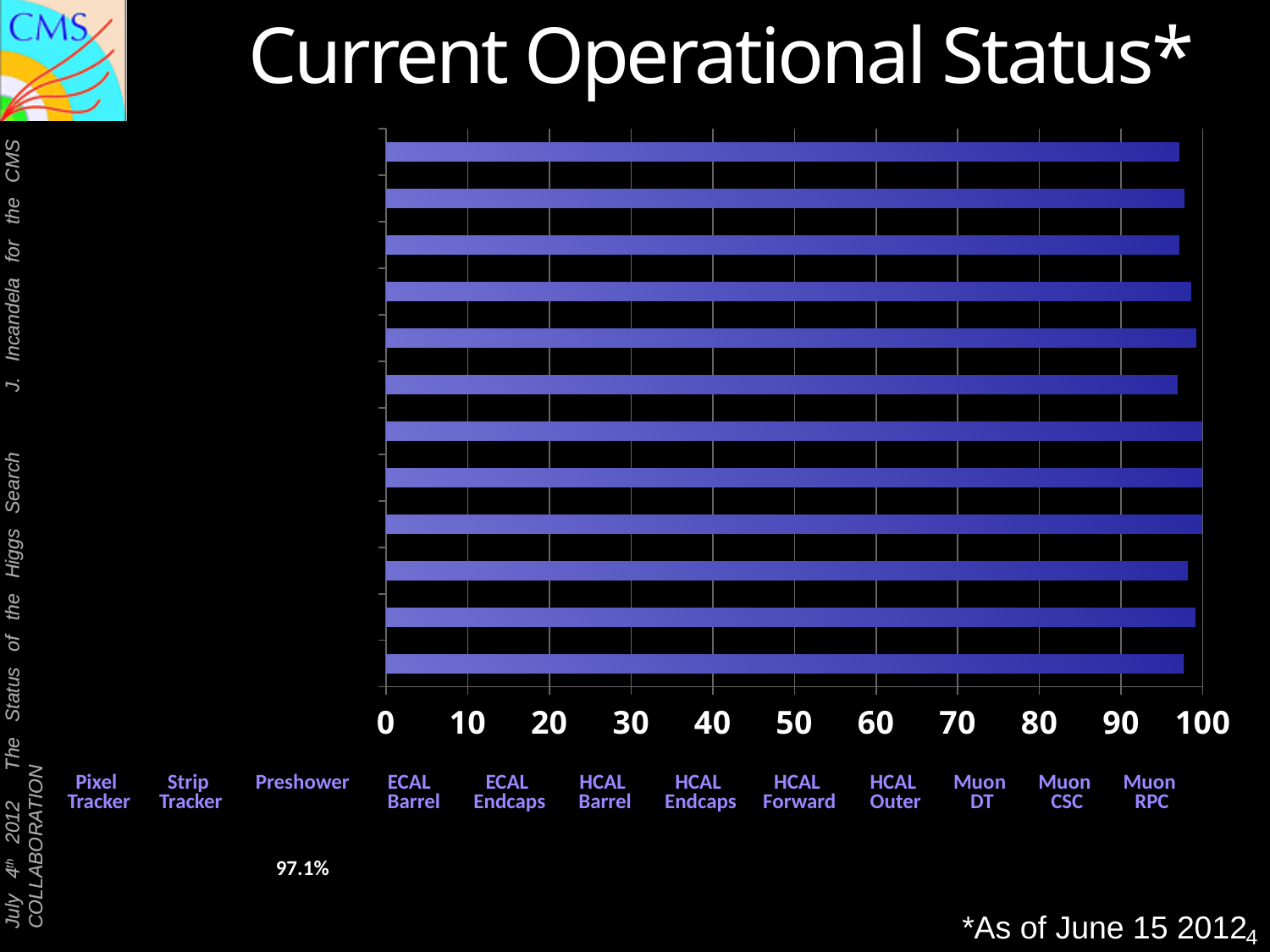
What is the highest value shown on the x axis of the chart? 100 How many bars are plotted in the chart? 12 Is any bar in the chart less than 60? no Is the value for the bottom bar in the chart greater or less than 50? greater What kind of chart is shown on the slide? bar chart Is the value for the top bar in the chart greater or less than 90? greater What is the title of the slide containing the chart? Current Operational Status*